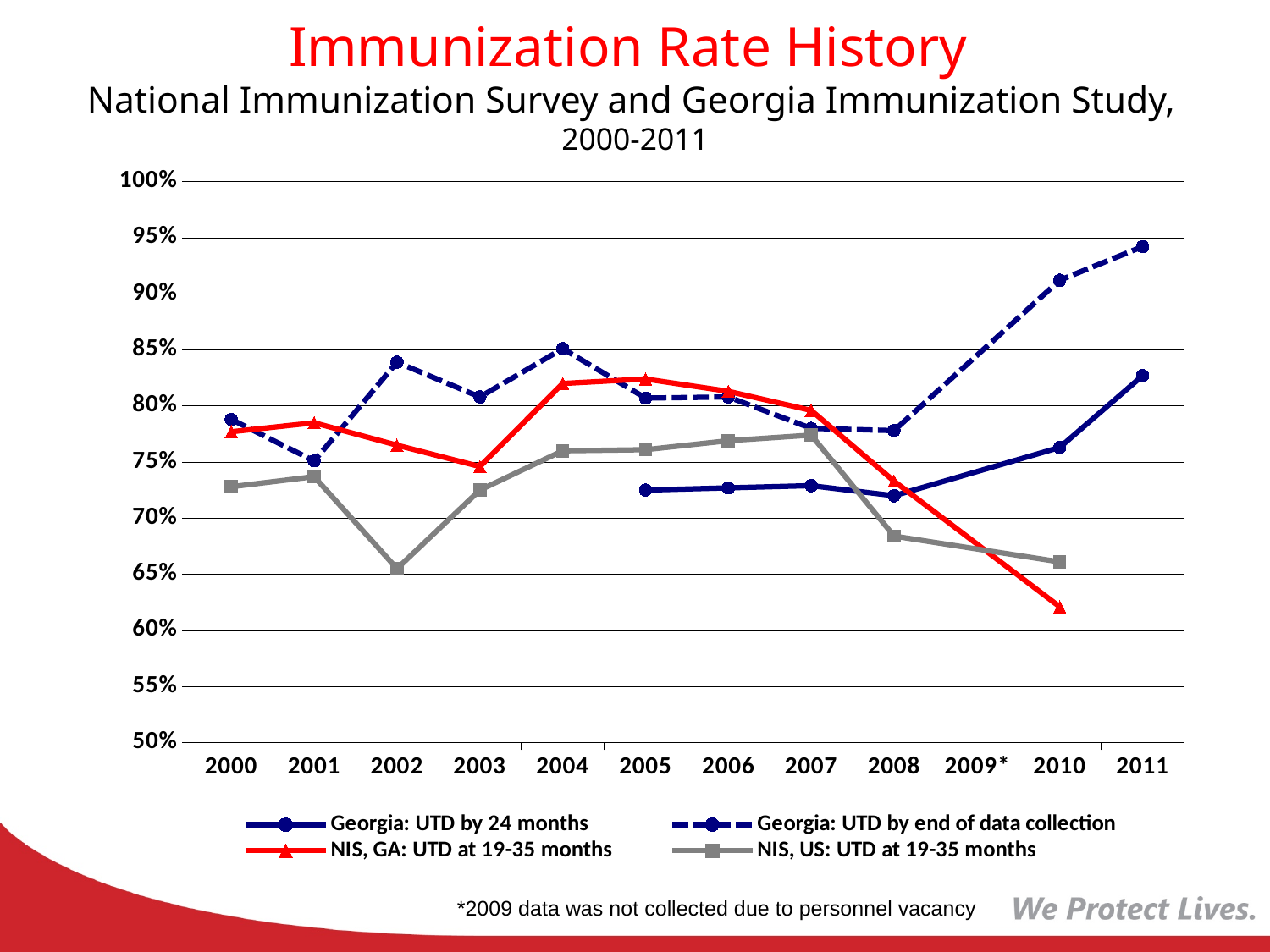
Does the NIS, GA: UTD at 19-35 months series rise or fall from 2007 to 2010? Fall Is the value for NIS, US: UTD at 19-35 months in 2002 greater or less than 70%? less In which year does the Georgia: UTD by end of data collection series reach its highest value? 2011 In 2004, which is higher: Georgia: UTD by end of data collection or NIS, GA: UTD at 19-35 months? Georgia: UTD by end of data collection In which year does the NIS, GA: UTD at 19-35 months series reach its lowest value? 2010 How many series does the legend list? 4 What kind of chart is shown on the slide? Line chart Which year on the x axis is marked with an asterisk? 2009 Is the value for Georgia: UTD by end of data collection in 2011 greater or less than 90%? greater How many years are labelled along the x axis? 12 Does the Georgia: UTD by 24 months series rise or fall from 2008 to 2011? Rise Is the value for NIS, GA: UTD at 19-35 months in 2010 greater or less than 65%? less